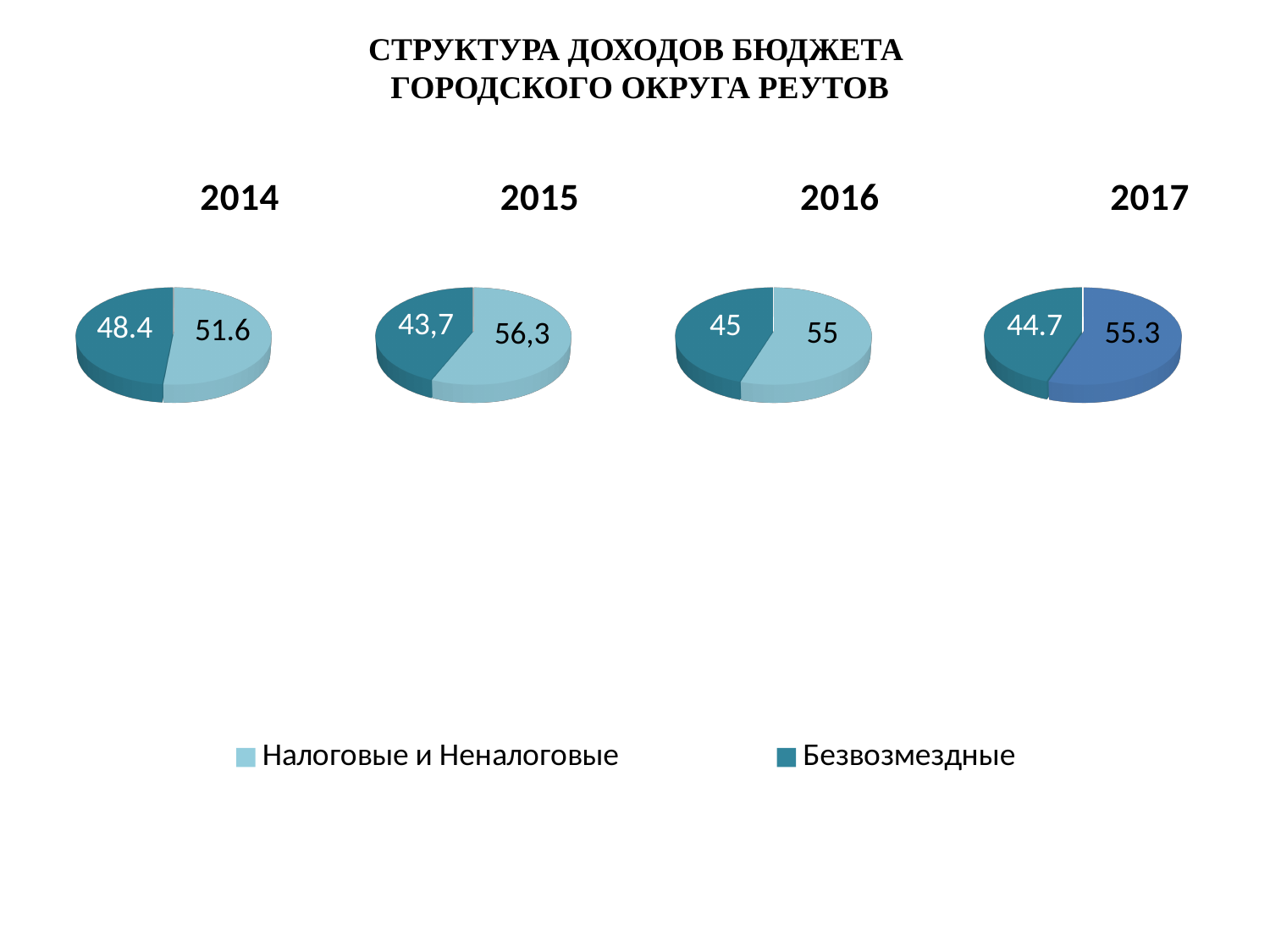
In the 2014 pie chart, what is the value for Налоговые и Неналоговые? 51.6 In the 2017 pie chart, what is the difference between the two slices? 10.6 In the 2015 pie chart, what is the value for Налоговые и Неналоговые? 56,3 In the 2016 pie chart, which slice is larger, Налоговые и Неналоговые or Безвозмездные? Налоговые и Неналоговые How many series does the legend list? 2 How many pie charts are shown on the slide? 4 In the 2015 pie chart, what is the value for Безвозмездные? 43,7 What kind of chart is used for the 2015 data? Pie chart In the 2014 pie chart, what is the value for Безвозмездные? 48.4 In the 2017 pie chart, what is the value for Безвозмездные? 44.7 In the 2016 pie chart, what is the difference between the Налоговые и Неналоговые slice and the Безвозмездные slice? 10 In the 2016 pie chart, what is the value for Безвозмездные? 45